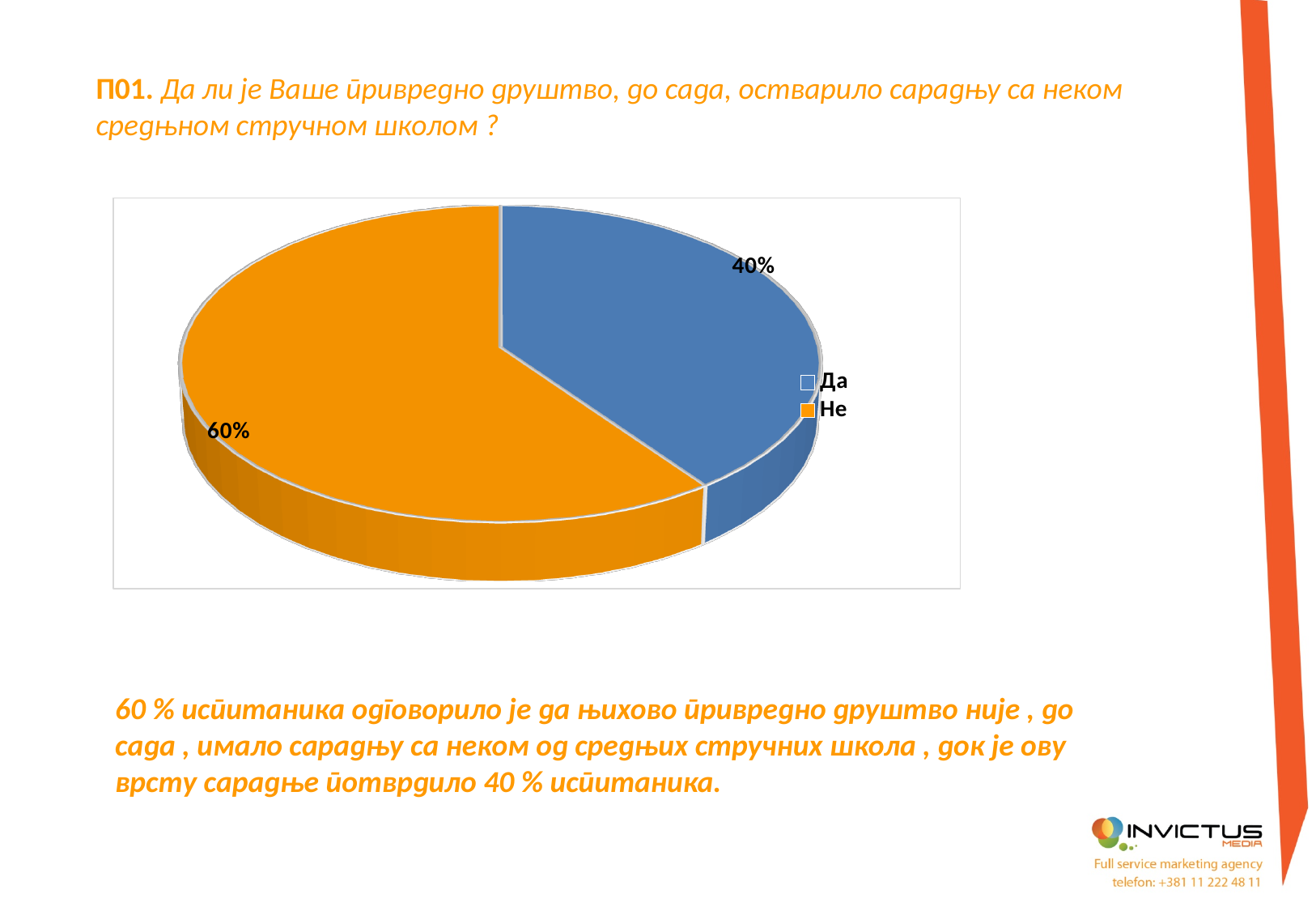
Which slice is the largest in the pie chart? Не How many entries does the legend list? 2 What percentage is shown for the "Да" slice? 40% Which slice is the smallest in the pie chart? Да What percentage is shown for the "Не" slice? 60% What colour is the "Не" slice in the pie chart? Orange What share of the pie does the "Не" slice represent? 60% What kind of chart is shown on the slide? Pie chart What colour is the "Да" slice in the pie chart? Blue Which is larger, the "Да" slice or the "Не" slice? Не What is the difference in percentage points between the "Не" and "Да" slices? 20 How many slices does the pie chart have? 2